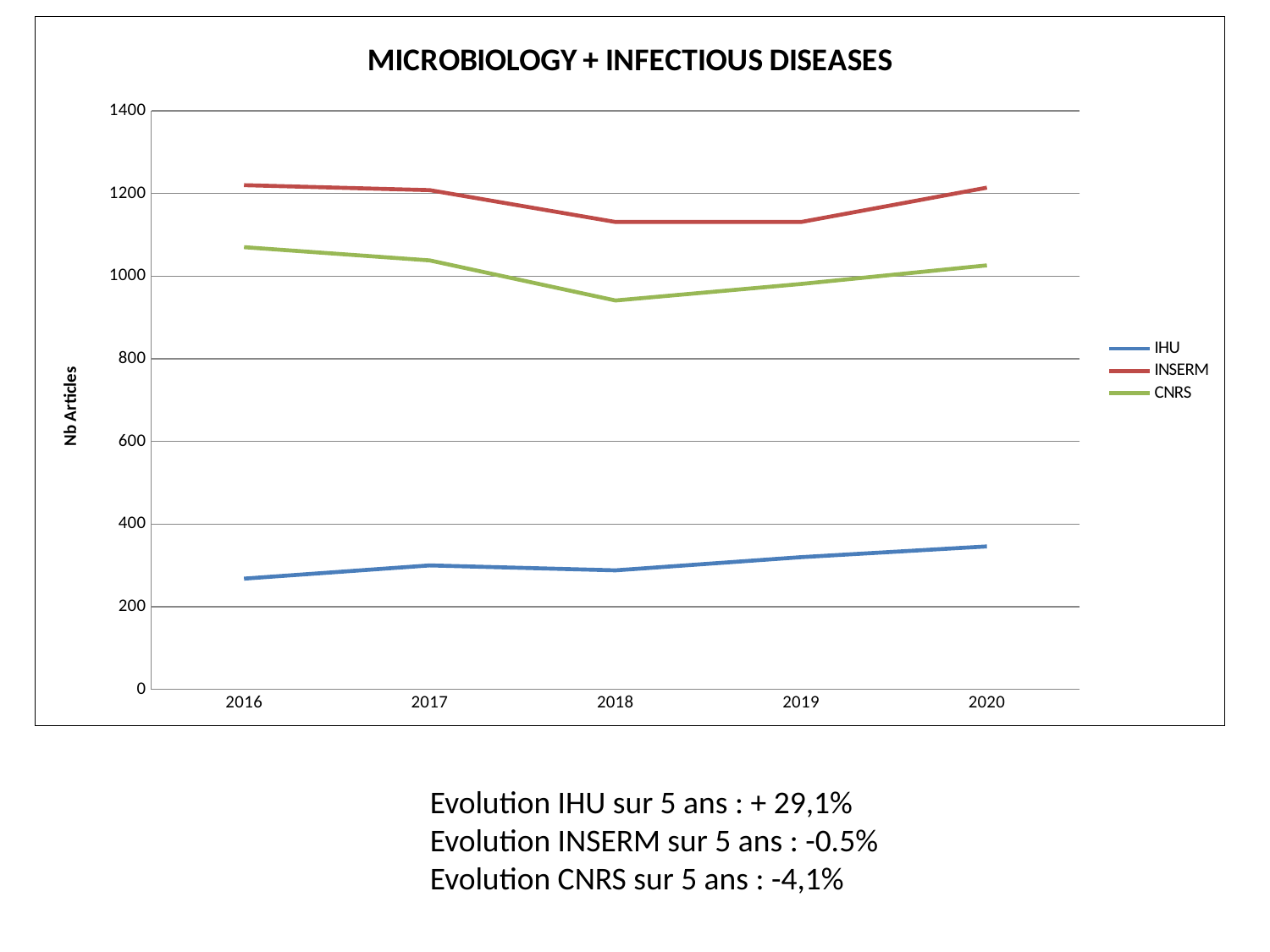
Which series has the highest value in 2016? INSERM Which series has the lowest value in 2020? IHU What is the label on the vertical axis? Nb Articles Is the value for IHU in 2016 greater or less than 400? less Does the IHU line rise or fall from 2018 to 2020? rise Is the value for CNRS in 2018 greater or less than 1000? less What is the title of the chart? MICROBIOLOGY + INFECTIOUS DISEASES How many series does the legend list? 3 What kind of chart is shown on the slide? line chart How many years are plotted along the x axis? 5 Which is larger for CNRS: the value in 2016 or the value in 2018? 2016 Is the value for INSERM in 2018 greater or less than 1000? greater